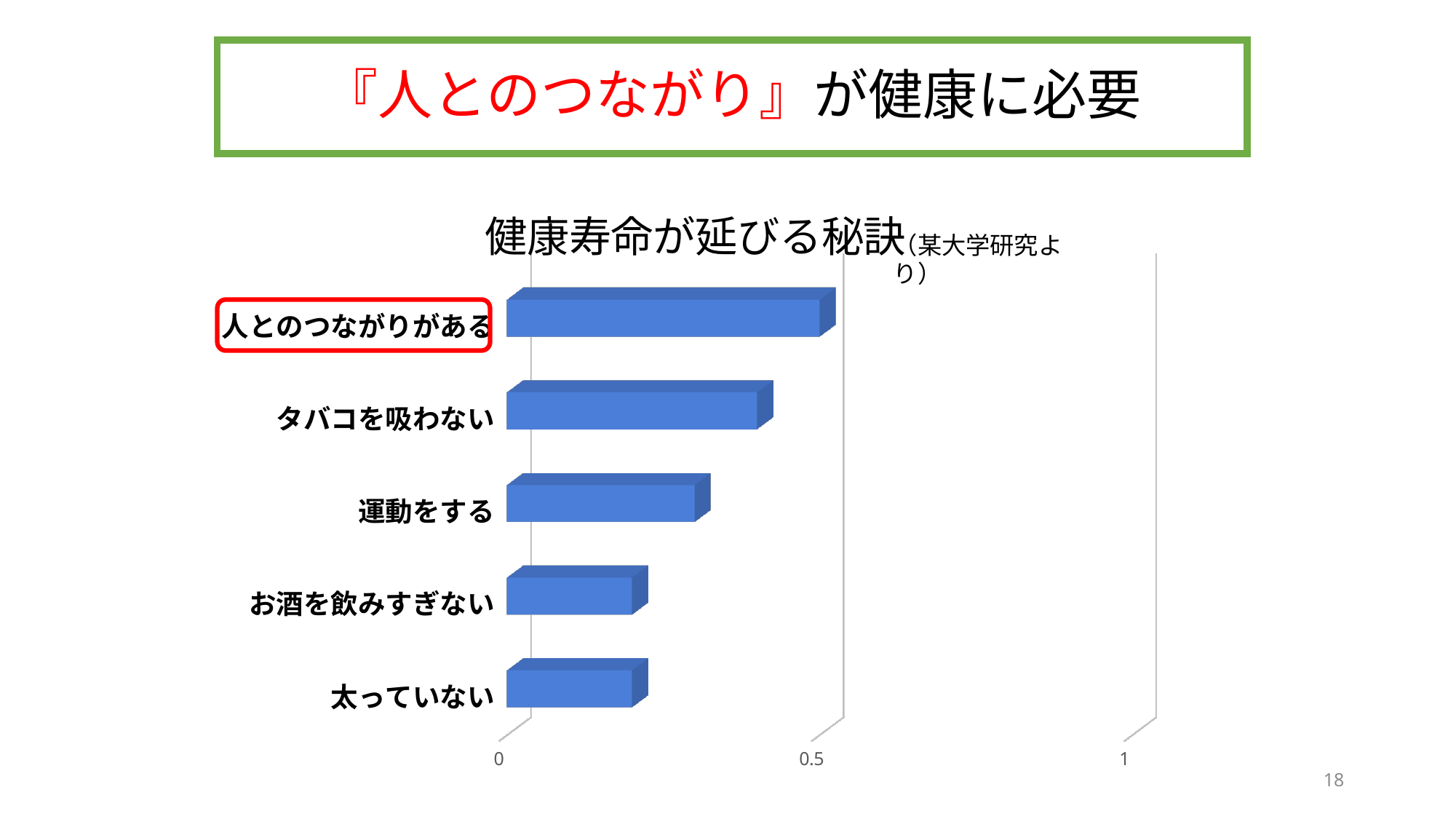
How many categories are plotted in the chart? 5 What is the title of the chart? 健康寿命が延びる秘訣（某大学研究より） Is the value for 太っていない greater or less than 0.5? less Is the value for タバコを吸わない greater or less than 0.5? less What kind of chart is shown on the slide? bar chart Which is larger, the value for 運動をする or the value for お酒を飲みすぎない? 運動をする Is the value for 人とのつながりがある greater or less than 1? less Which is larger, the value for 人とのつながりがある or the value for タバコを吸わない? 人とのつながりがある Which category label is highlighted with a red box in the chart? 人とのつながりがある Which is larger, the value for タバコを吸わない or the value for 運動をする? タバコを吸わない Which category has the highest value in the chart? 人とのつながりがある